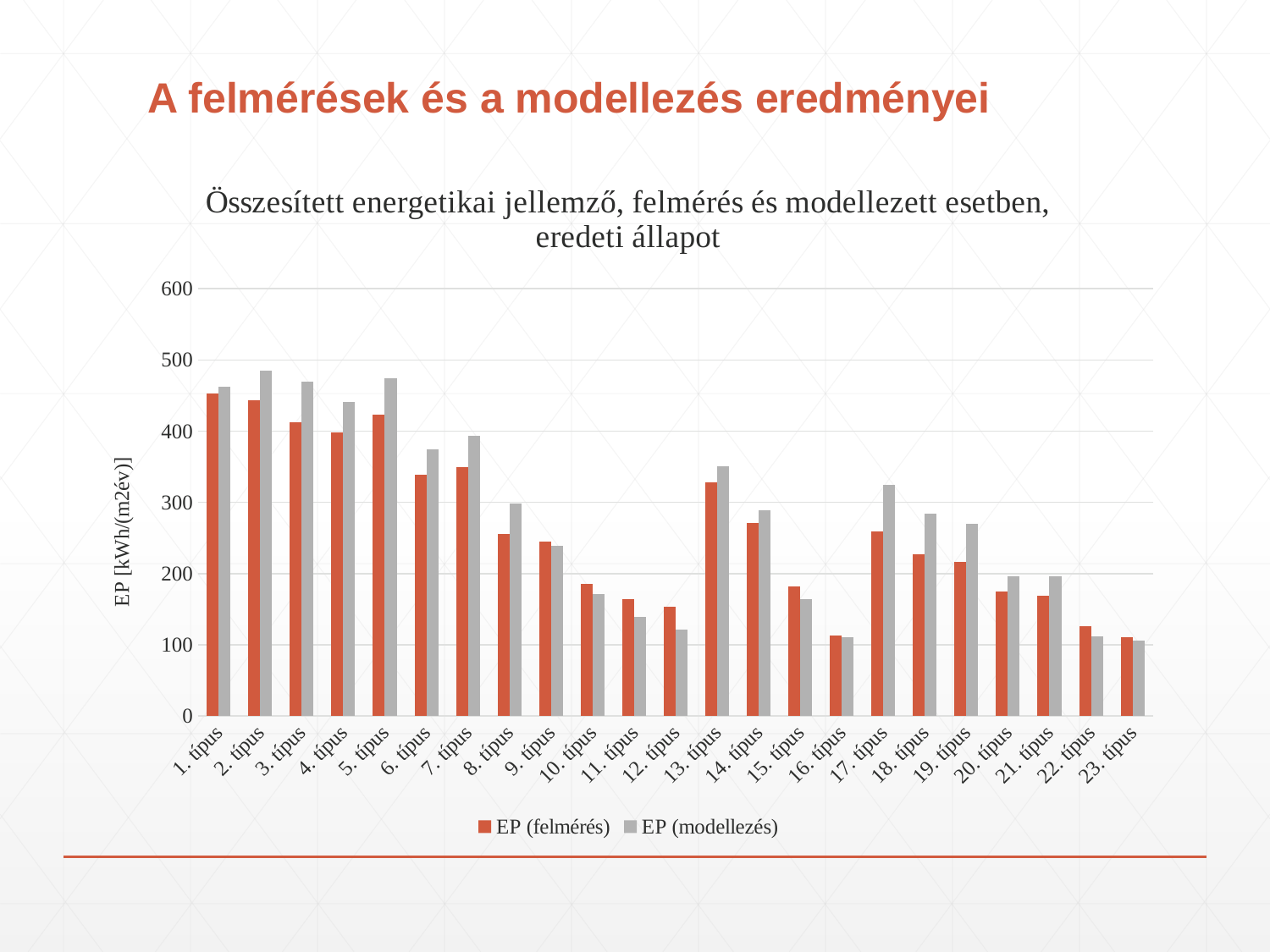
Is the EP (modellezés) value for 12. típus greater or less than 150? less Is the EP (modellezés) value for 13. típus greater or less than 300? greater Is the EP (felmérés) value for 8. típus greater or less than 200? greater What kind of chart is shown on the slide? bar chart For 12. típus, which series has the larger value, EP (felmérés) or EP (modellezés)? EP (felmérés) How many series does the legend list? 2 For 17. típus, which series has the larger value, EP (felmérés) or EP (modellezés)? EP (modellezés) What is the label of the vertical axis? EP [kWh/(m2év)] What is the title of the chart? Összesített energetikai jellemző, felmérés és modellezett esetben, eredeti állapot How many building types (categories) are shown on the x axis? 23